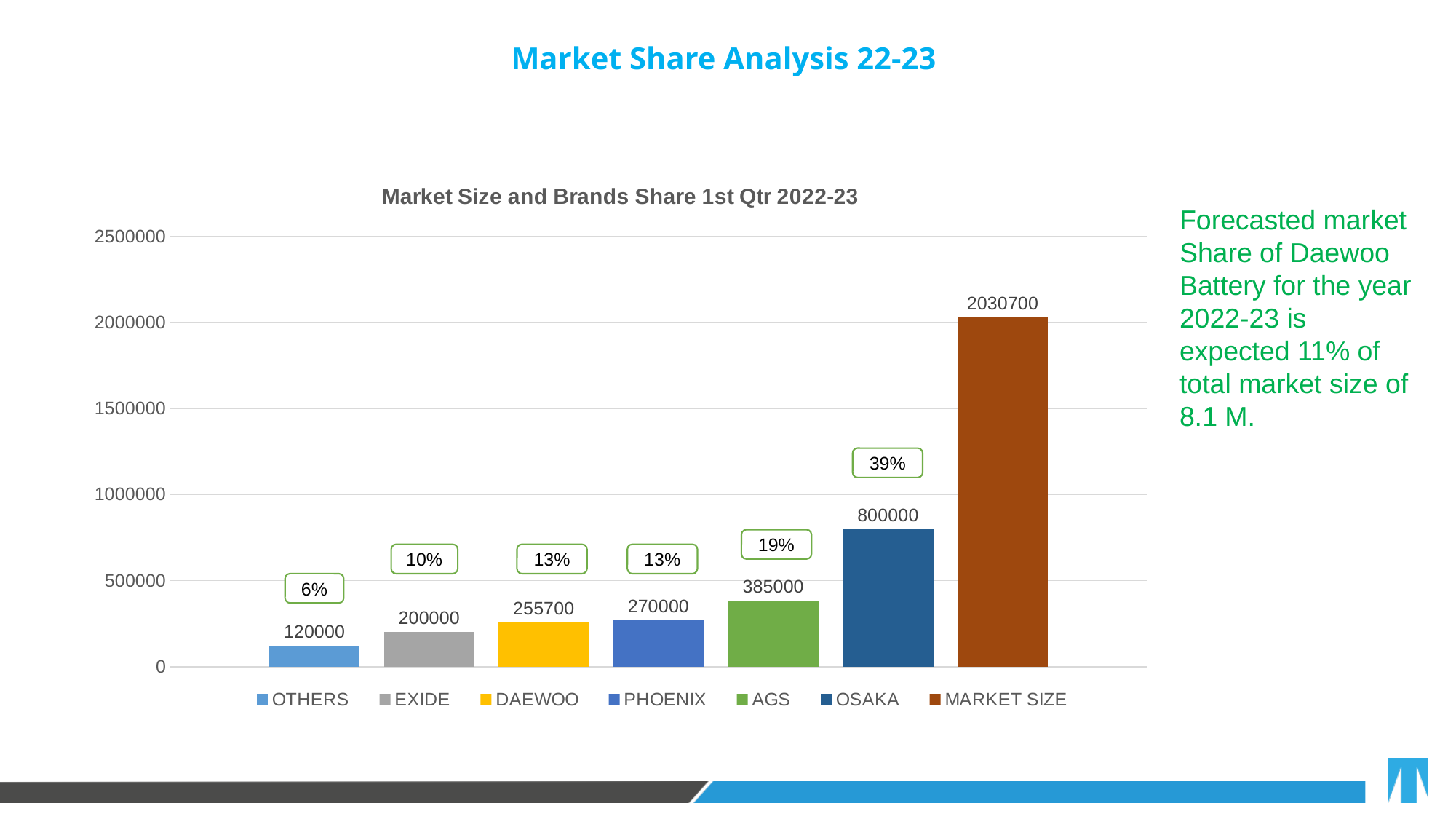
What is the title of the chart? Market Size and Brands Share 1st Qtr 2022-23 Which is larger, the value for PHOENIX or the value for EXIDE? PHOENIX Which bar is the highest? MARKET SIZE How many bars are shown in the chart? 7 What is the value for MARKET SIZE? 2030700 What kind of chart is shown? bar chart What is the difference between the values for OSAKA and AGS? 415000 What is the value for DAEWOO? 255700 What is the value for OSAKA? 800000 What percentage share is shown above the OSAKA bar? 39% Which brand has the lowest value? OTHERS Is the value for AGS greater or less than 500000? less